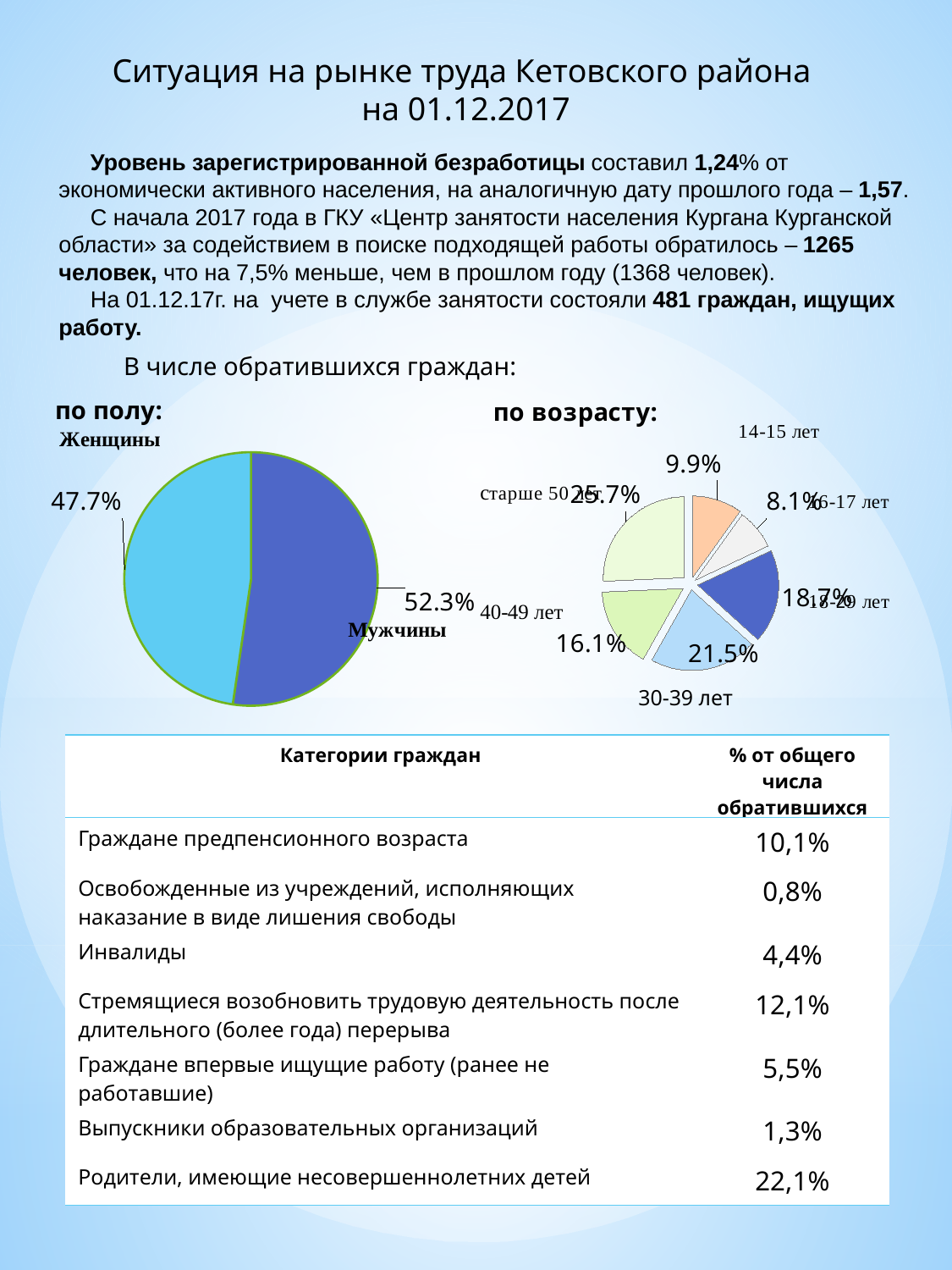
In the 'по возрасту' pie chart, which age group has the smallest share? 16-17 лет In the 'по возрасту' pie chart, which age group has the largest share? старше 50 лет In the 'по возрасту' pie chart, what is the value for 40-49 лет? 16.1% In the 'по полу' pie chart, what is the value for Женщины? 47.7% In the 'по полу' pie chart, what is the value for Мужчины? 52.3% In the 'по возрасту' pie chart, what is the difference between the 30-39 лет and 18-29 лет shares? 2.8% In the 'по возрасту' pie chart, what is the value for 30-39 лет? 21.5% In the 'по возрасту' pie chart, what is the value for 14-15 лет? 9.9% In the 'по полу' pie chart, what is the difference between the Мужчины and Женщины shares? 4.6% In the 'по полу' pie chart, which category has the larger share, Мужчины or Женщины? Мужчины In the 'по возрасту' pie chart, how many age groups are shown? 6 What kind of chart is the 'по возрасту' chart? pie chart